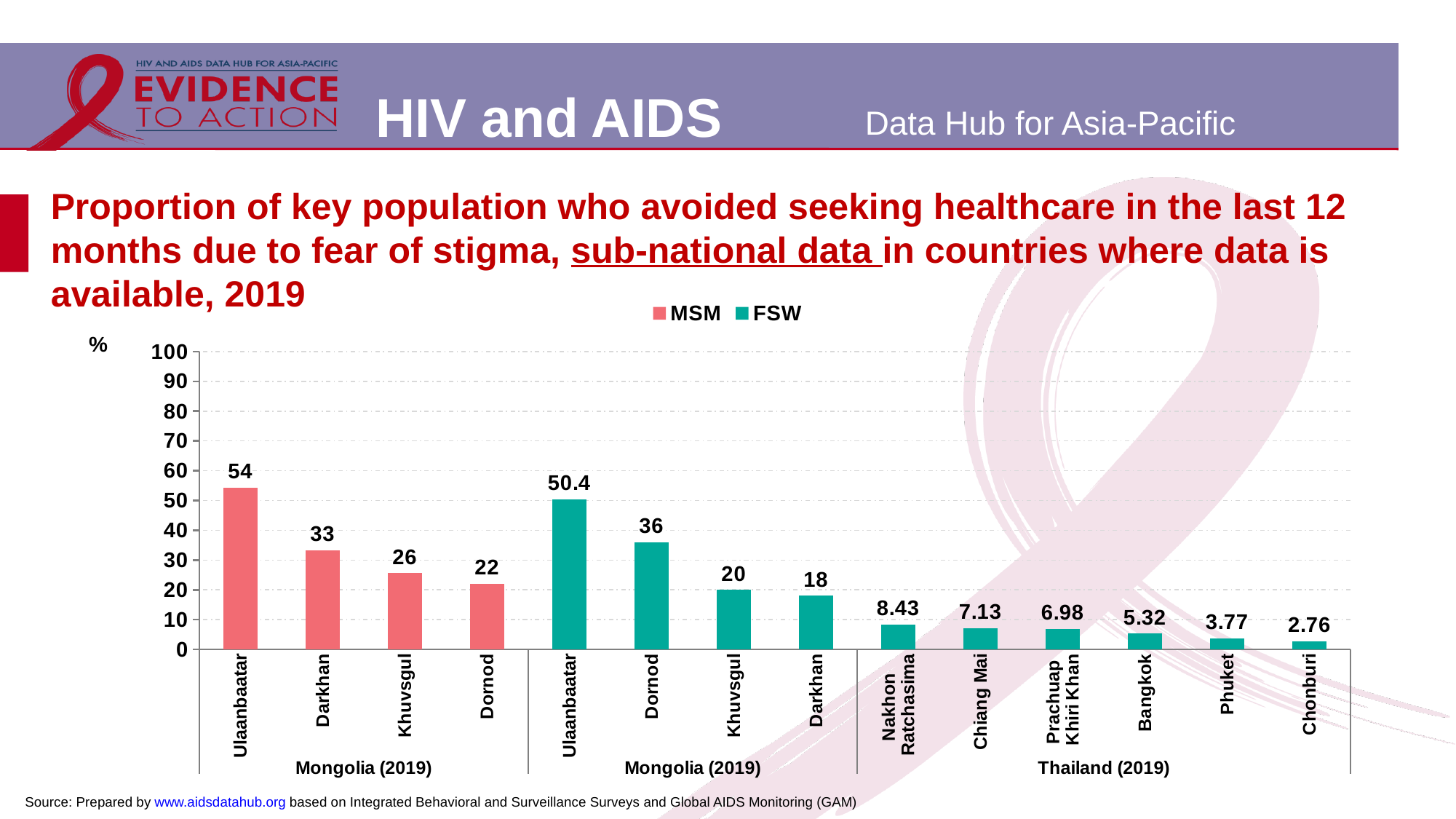
What is the value for FSW in Dornod, Mongolia? 36 Which is larger: the MSM value for Darkhan or the FSW value for Darkhan? MSM value for Darkhan What is the value for FSW in Bangkok, Thailand? 5.32 What is the difference between the MSM value for Ulaanbaatar and the FSW value for Ulaanbaatar in Mongolia? 3.6 Is the FSW value for Nakhon Ratchasima greater or less than 10? less How many series does the legend list? 2 Which location has the highest value among the MSM bars? Ulaanbaatar What is the value for MSM in Ulaanbaatar, Mongolia? 54 Which Thailand location has the lowest value? Chonburi What kind of chart is shown on the slide? Bar chart Do the values for the Thailand locations rise or fall from left to right? Fall How many bars are plotted in the chart? 14